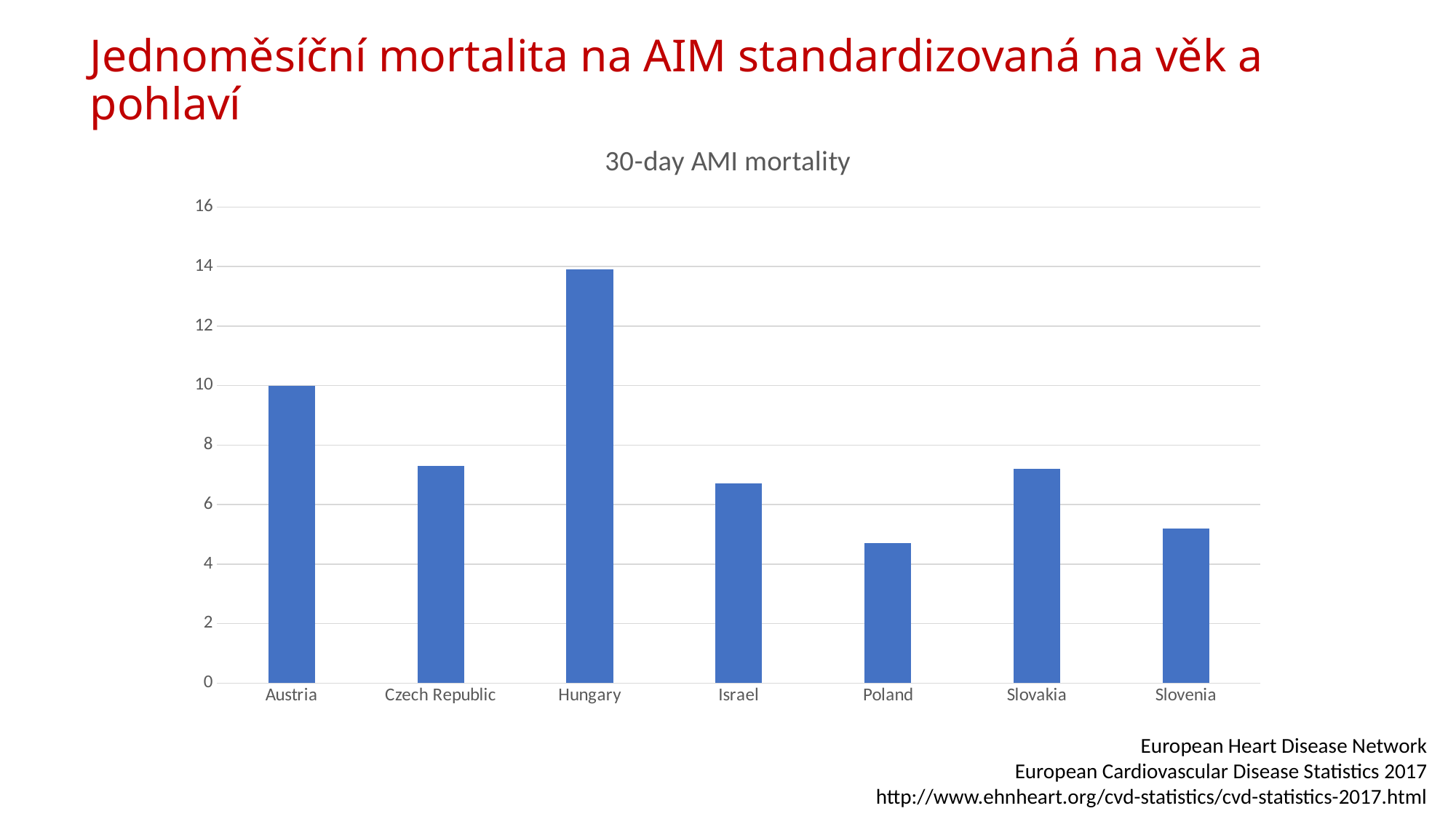
Is the value for Slovenia greater or less than 4? greater Which has a higher 30-day AMI mortality, Israel or Slovenia? Israel Which country has the highest 30-day AMI mortality? Hungary Is the value for Czech Republic greater or less than 8? less What type of chart is shown on the slide? bar chart Is the value for Poland greater or less than 6? less Which has a higher 30-day AMI mortality, Austria or Slovakia? Austria How many countries are shown on the chart? 7 What is the 30-day AMI mortality value for Austria? 10 Which country has the lowest 30-day AMI mortality? Poland What is the title of the chart? 30-day AMI mortality